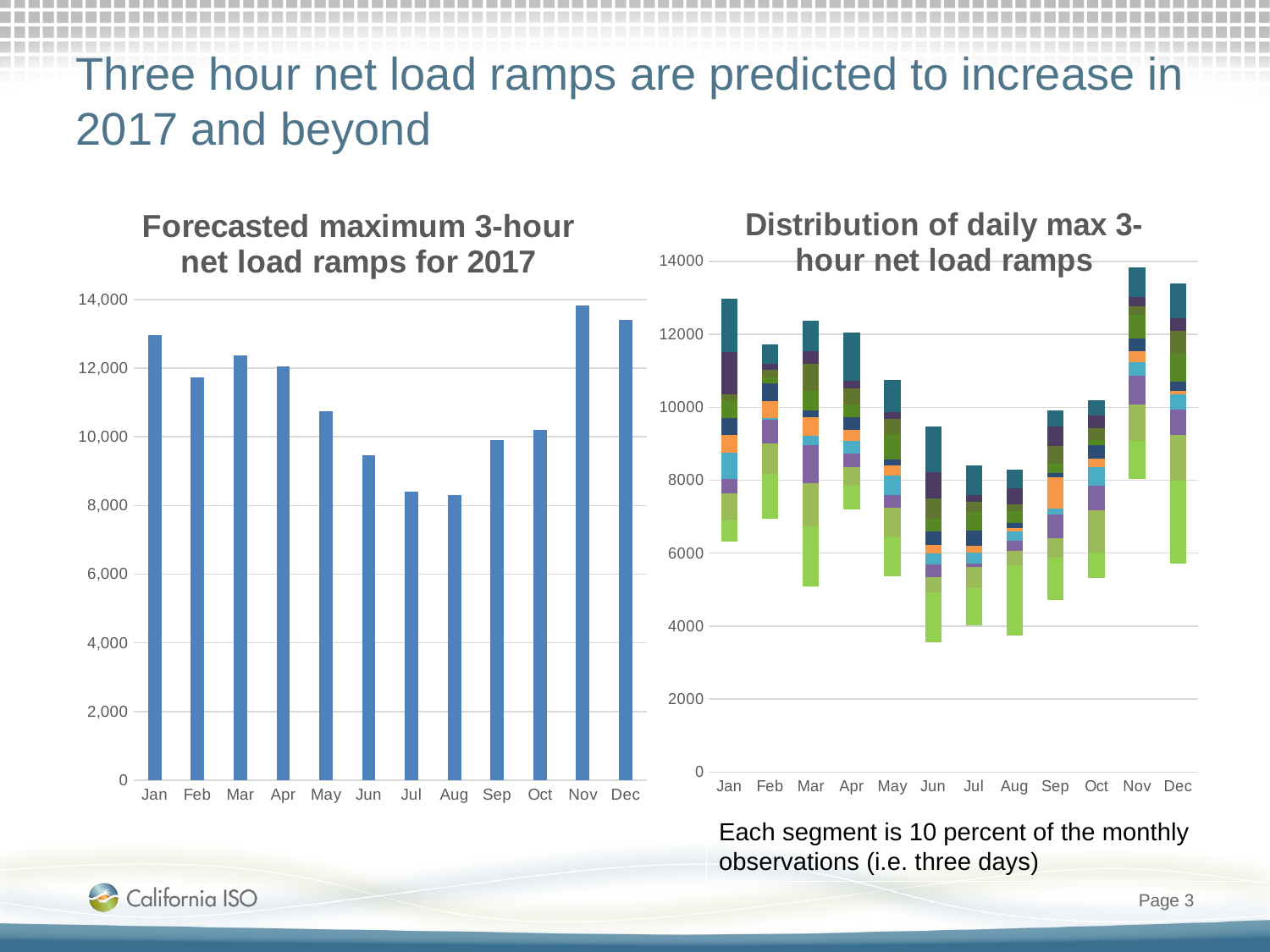
In the 'Forecasted maximum 3-hour net load ramps for 2017' chart, which is larger, the value for Nov or the value for Jun? Nov In the 'Forecasted maximum 3-hour net load ramps for 2017' chart, which is larger, the value for Aug or the value for Jan? Jan According to the note under the 'Distribution of daily max 3-hour net load ramps' chart, what share of the monthly observations does each segment represent? 10 percent What is the title of the chart on the right side of the slide? Distribution of daily max 3-hour net load ramps How many months are shown on the x axis of the 'Forecasted maximum 3-hour net load ramps for 2017' chart? 12 In the 'Forecasted maximum 3-hour net load ramps for 2017' chart, do the values rise or fall from Apr to Jul? fall In the 'Forecasted maximum 3-hour net load ramps for 2017' chart, is the value for Jun greater or less than 10,000? less In the 'Forecasted maximum 3-hour net load ramps for 2017' chart, is the value for Feb greater or less than 12,000? less What kind of chart is the 'Forecasted maximum 3-hour net load ramps for 2017' chart? bar chart In the 'Forecasted maximum 3-hour net load ramps for 2017' chart, which month has the highest bar? Nov In the 'Forecasted maximum 3-hour net load ramps for 2017' chart, do the values rise or fall from Aug to Nov? rise In the 'Forecasted maximum 3-hour net load ramps for 2017' chart, is the value for Jan greater or less than 12,000? greater